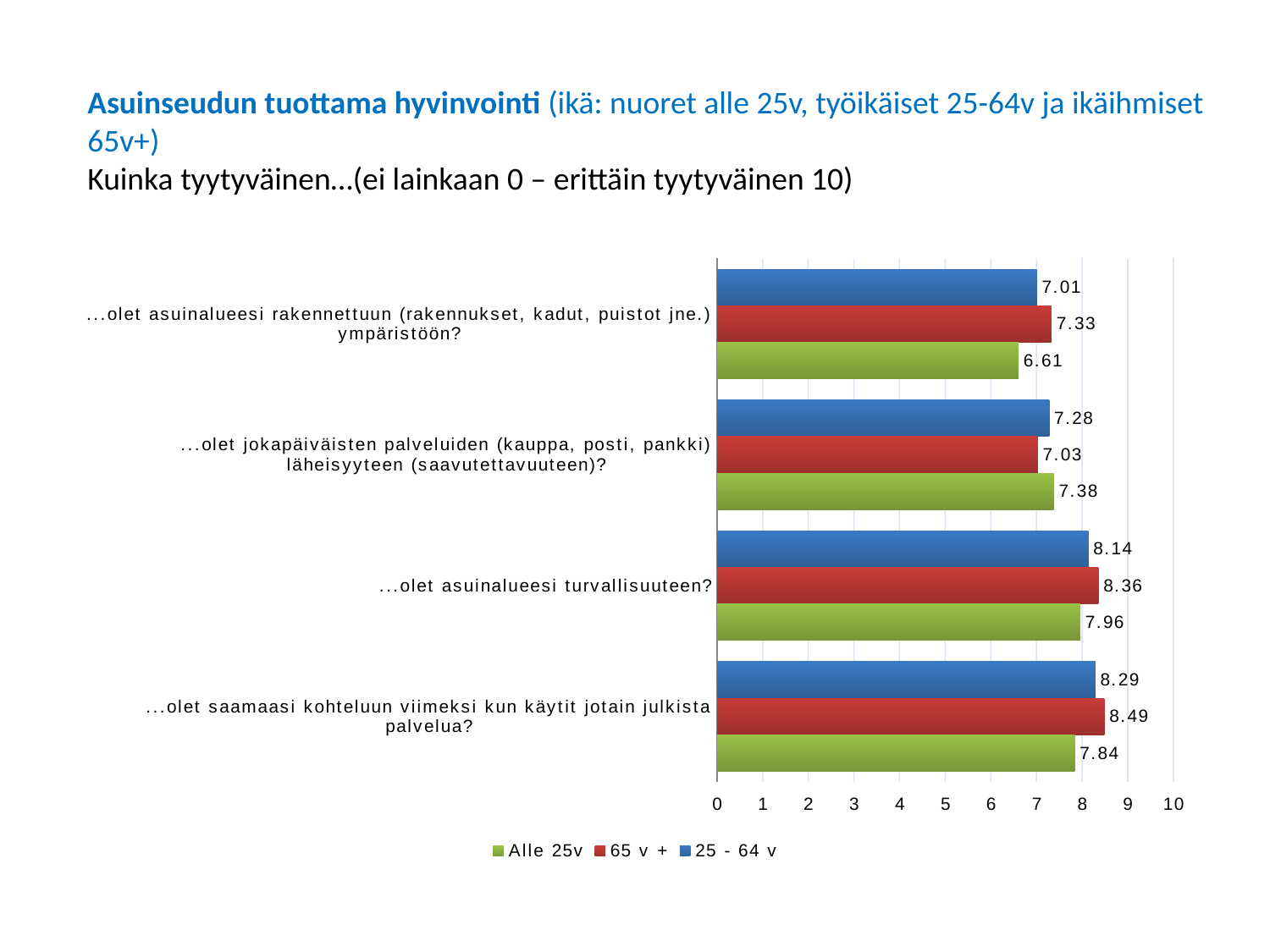
How many series does the legend list? 3 What is the value for the 65 v + series for "...olet asuinalueesi turvallisuuteen?"? 8.36 What colour are the bars for the 65 v + series? red What type of chart is shown on the slide? bar chart Which is larger for "...olet asuinalueesi rakennettuun (rakennukset, kadut, puistot jne.) ympäristöön?": the 65 v + value or the 25 - 64 v value? 65 v + How many question categories are plotted on the chart? 4 What is the value for the Alle 25v series for "...olet asuinalueesi rakennettuun (rakennukset, kadut, puistot jne.) ympäristöön?"? 6.61 Which series has the lowest value for "...olet saamaasi kohteluun viimeksi kun käytit jotain julkista palvelua?"? Alle 25v What is the difference between the 65 v + and Alle 25v values for "...olet saamaasi kohteluun viimeksi kun käytit jotain julkista palvelua?"? 0.65 Is the Alle 25v value for "...olet asuinalueesi turvallisuuteen?" greater or less than 7? greater Which series has the highest value for "...olet jokapäiväisten palveluiden (kauppa, posti, pankki) läheisyyteen (saavutettavuuteen)?"? Alle 25v What is the value for the 25 - 64 v series for "...olet saamaasi kohteluun viimeksi kun käytit jotain julkista palvelua?"? 8.29